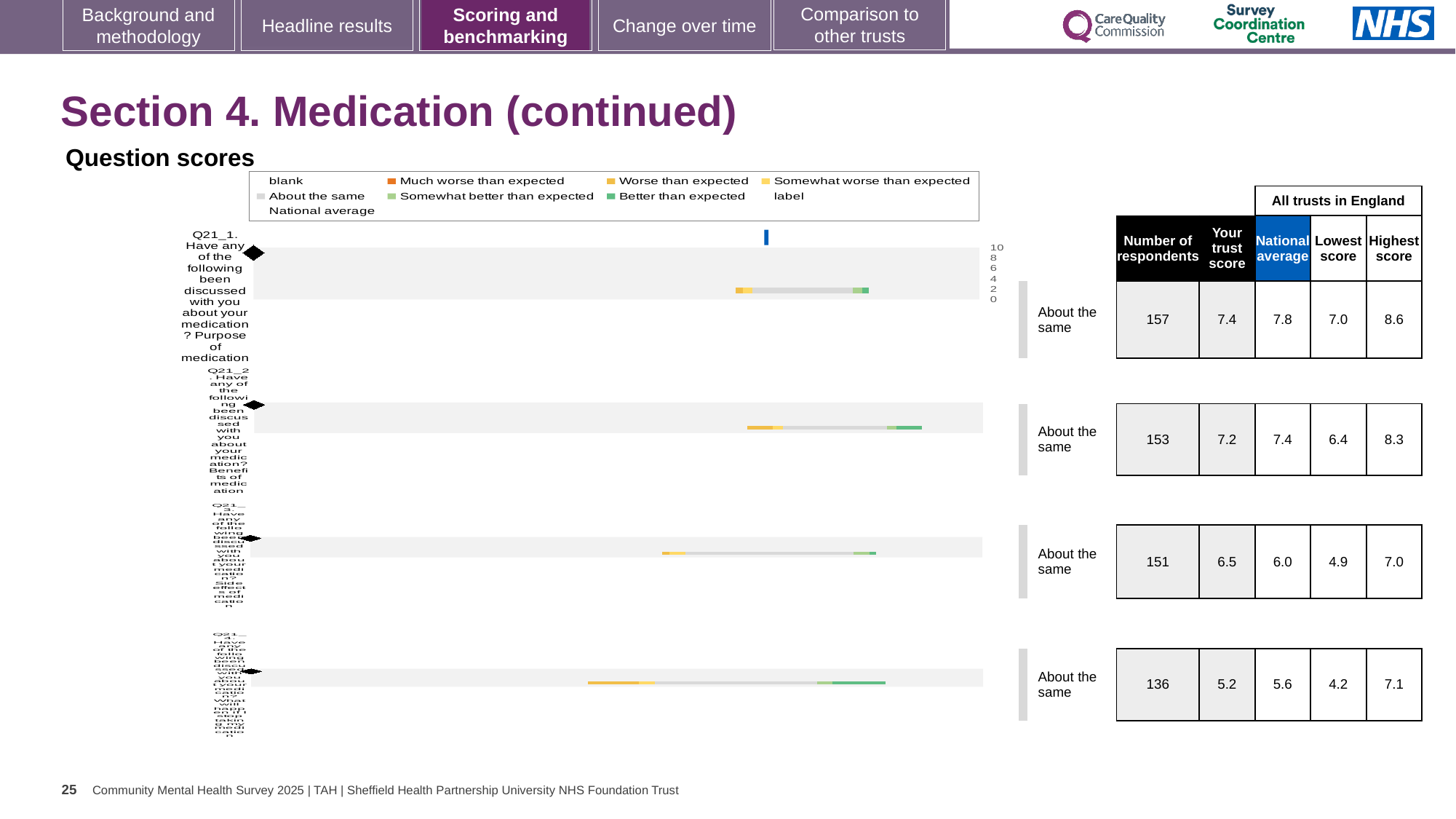
How many questions are plotted in the Question scores chart? 4 What is the national average for Q21_3 (Side effects of medication)? 6.0 For Q21_3 (Side effects of medication), is the trust score higher or lower than the national average? higher Which question has the lowest 'Your trust score'? Q21_4 What is the lowest score across all trusts in England for Q21_2 (Benefits of medication)? 6.4 Which question has the highest number of respondents? Q21_1 What is the highest score across all trusts in England for Q21_4 (What might happen if stop taking medication)? 7.1 How many respondents are shown for Q21_1 (Purpose of medication)? 157 What is the 'Your trust score' for Q21_2 (Benefits of medication)? 7.2 What kind of chart is used for the Question scores? bar chart What benchmark category is shown next to each of the four questions? About the same What is the difference between the national average and the trust score for Q21_1 (Purpose of medication)? 0.4